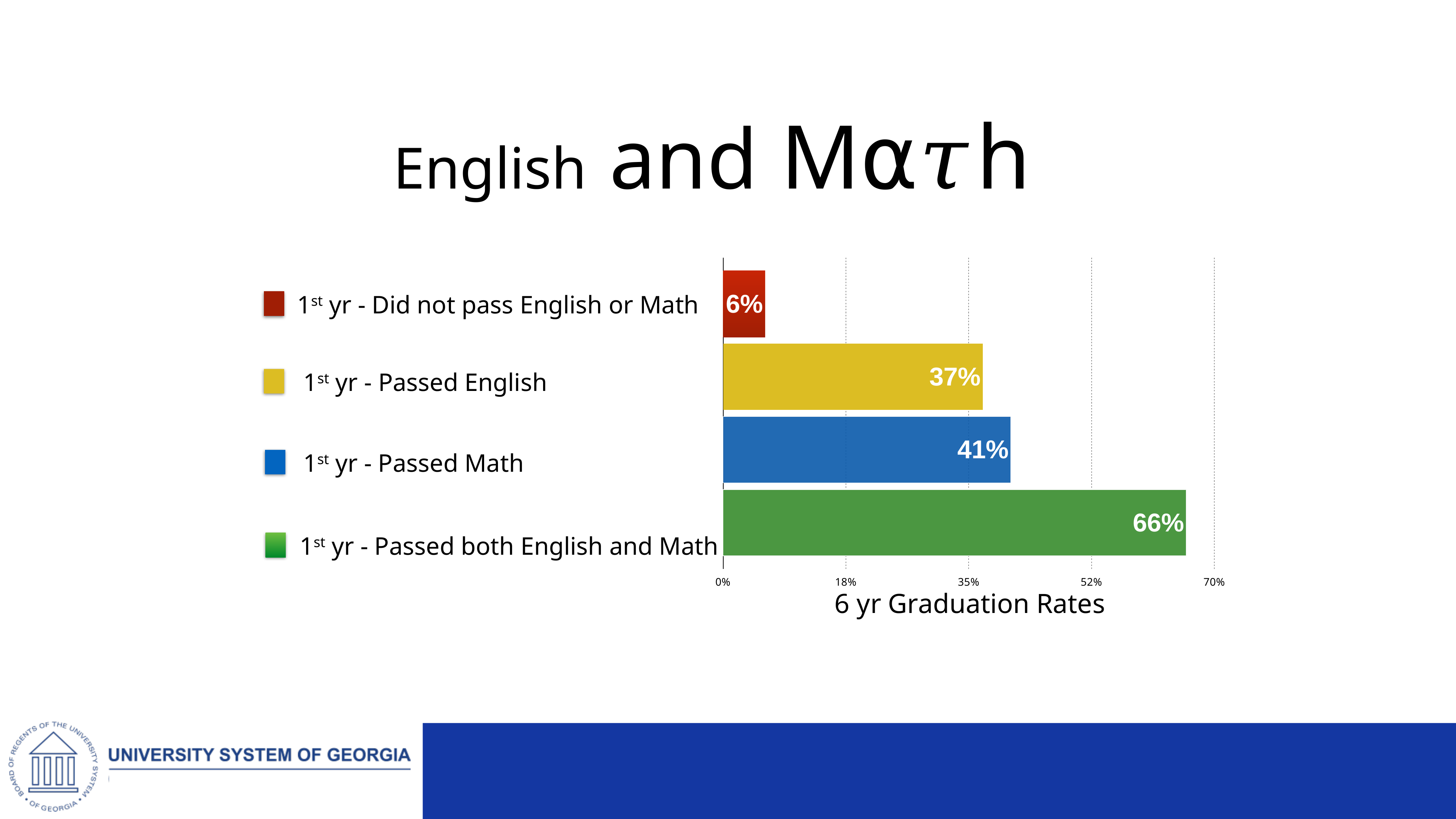
What is the label on the horizontal axis of the chart? 6 yr Graduation Rates How many groups are shown in the chart? 4 What is the 6 yr graduation rate for students who passed Math in their 1st year? 41% Which group has the lowest 6 yr graduation rate? 1st yr - Did not pass English or Math What is the difference in 6 yr graduation rate between students who passed Math and those who passed English? 4% What kind of chart is shown on the slide? Bar chart Which group has the highest 6 yr graduation rate? 1st yr - Passed both English and Math Which group has a higher 6 yr graduation rate: 1st yr - Passed Math or 1st yr - Passed English? 1st yr - Passed Math What is the 6 yr graduation rate for students who did not pass English or Math in their 1st year? 6% What is the 6 yr graduation rate for students who passed English in their 1st year? 37% What is the difference in 6 yr graduation rate between students who passed both English and Math and those who did not pass either? 60% What is the 6 yr graduation rate for students who passed both English and Math in their 1st year? 66%